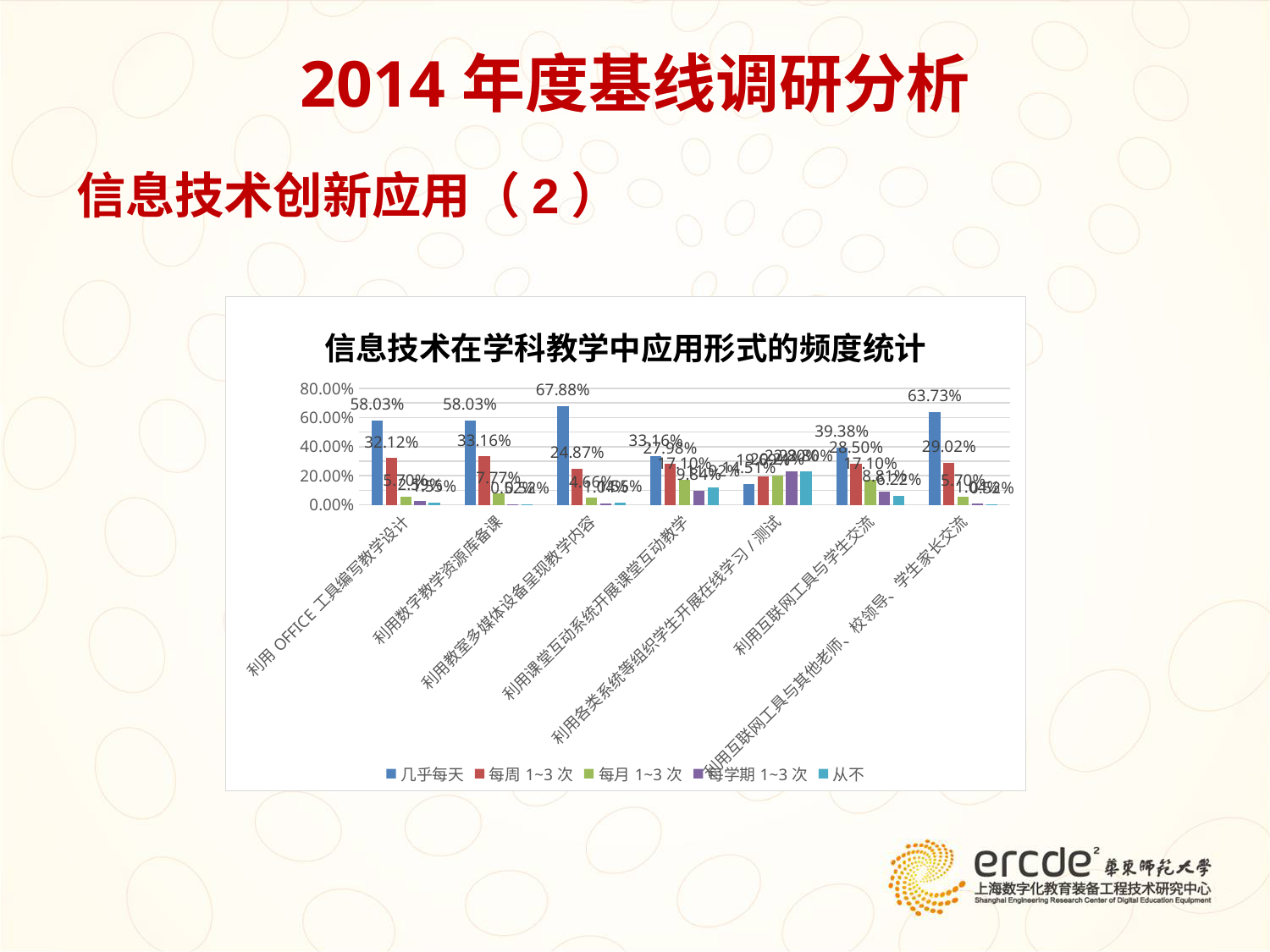
What is the difference between the 几乎每天 and 每周 1~3 次 values for 利用数字教学资源库备课? 24.87% What is the value of 每周 1~3 次 for 利用 OFFICE 工具编写教学设计? 32.12% What is the title of the chart? 信息技术在学科教学中应用形式的频度统计 What is the value of 几乎每天 for 利用教室多媒体设备呈现教学内容? 67.88% Which category has the highest 几乎每天 value? 利用教室多媒体设备呈现教学内容 What is the value of 几乎每天 for 利用互联网工具与学生交流? 39.38% What is the value of 几乎每天 for 利用互联网工具与其他老师、校领导、学生家长交流? 63.73% How many series does the legend list? 5 Is the 几乎每天 value for 利用课堂互动系统开展课堂互动教学 greater or less than 40.00%? less Which category has the lowest 几乎每天 value? 利用各类系统等组织学生开展在线学习 / 测试 How many categories are shown on the x axis? 7 What type of chart is shown on the slide? bar chart